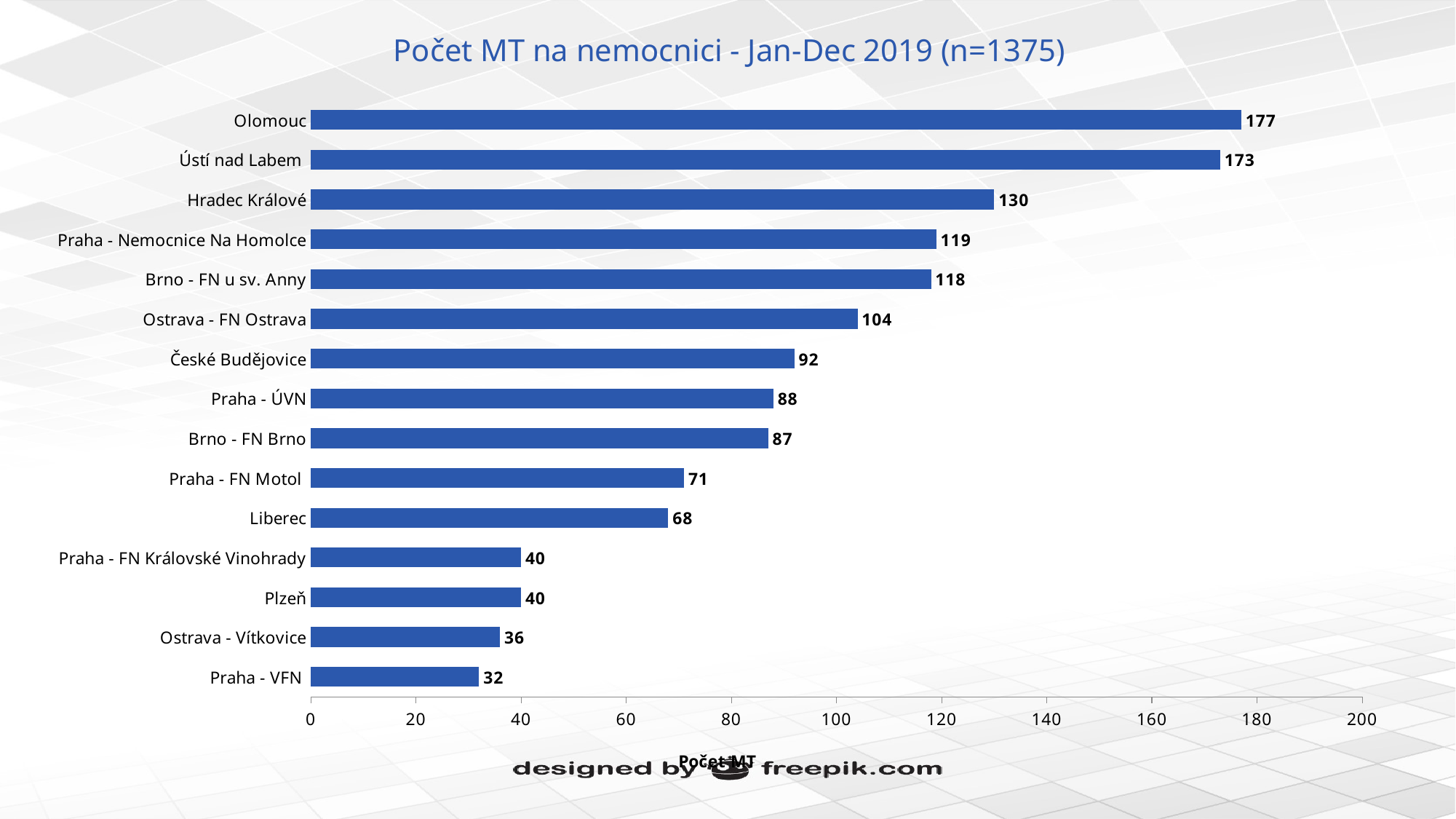
Which hospital has the highest value? Olomouc Which hospital has the lowest value? Praha - VFN What is the value for Praha - FN Motol? 71 What is the difference between the values for Hradec Králové and Liberec? 62 What is the value for Ostrava - Vítkovice? 36 What is the label of the horizontal axis? Počet MT What is the value for Olomouc? 177 What kind of chart is shown on the slide? bar chart Which is larger, the value for České Budějovice or the value for Praha - ÚVN? České Budějovice What is the title of the chart? Počet MT na nemocnici - Jan-Dec 2019 (n=1375) What is the difference between the values for Olomouc and Ústí nad Labem? 4 How many hospitals are shown in the chart? 15